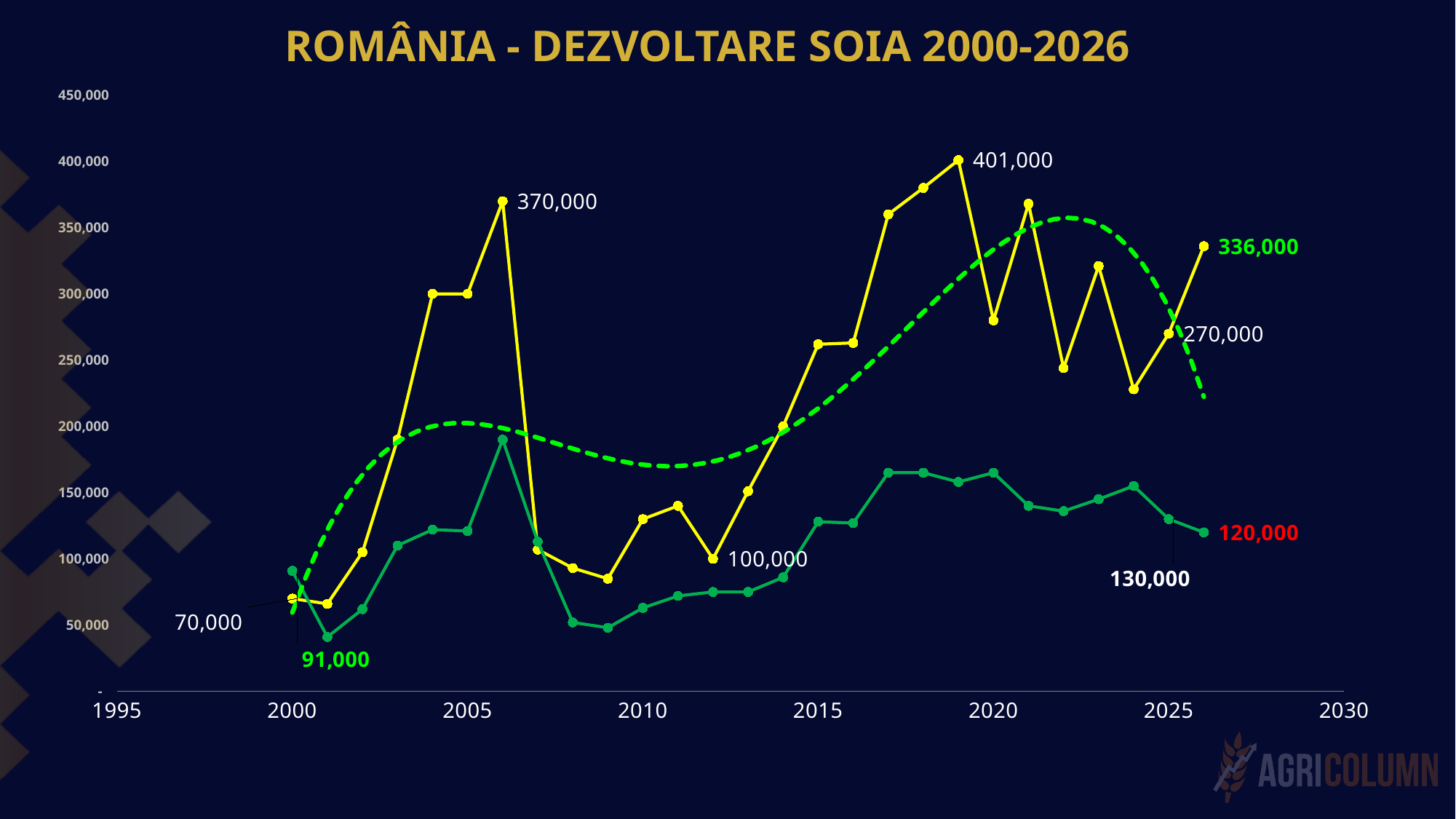
What is the difference between the yellow line's 2019 value and its 2006 value? 31,000 What is the value of the yellow line in 2000? 70,000 What is the value of the yellow line in 2006? 370,000 In which year does the yellow line reach its highest value? 2019 What is the difference between the yellow line and the green line in 2026? 216,000 Is the value of the green line in 2009 greater or less than 100,000? less Is the value of the yellow line in 2021 greater or less than 350,000? greater What is the value of the yellow line in 2026? 336,000 What kind of chart is shown on the slide? line chart What is the value of the yellow line in 2019? 401,000 What is the value of the green line in 2026? 120,000 What is the title of the chart? ROMÂNIA - DEZVOLTARE SOIA 2000-2026